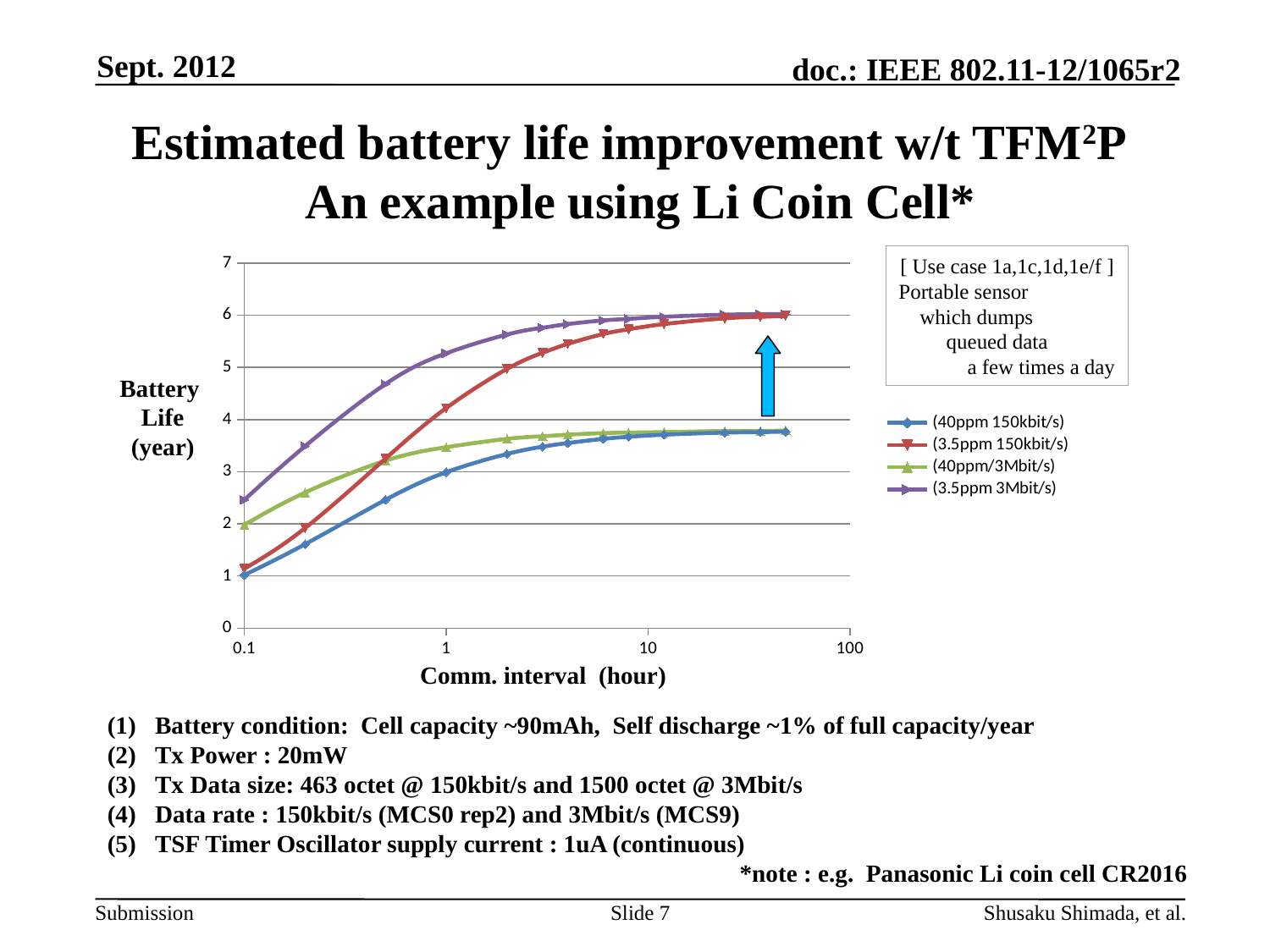
What is the title of the chart's x axis? Comm. interval (hour) Which series has the highest battery life at a communication interval of 0.1 hour? (3.5ppm 3Mbit/s) Is the battery life for (40ppm/3Mbit/s) at a 10 hour interval greater or less than 4 years? less At a 1 hour interval, which series has the larger battery life: (3.5ppm 150kbit/s) or (40ppm/3Mbit/s)? (3.5ppm 150kbit/s) Is the battery life for (3.5ppm 150kbit/s) at a 0.1 hour interval greater or less than 2 years? less What is the title of the chart's y axis? Battery Life (year) Is the battery life for (3.5ppm 3Mbit/s) at a 0.1 hour interval greater or less than 2 years? greater At a 0.1 hour interval, which series has the larger battery life: (3.5ppm 3Mbit/s) or (40ppm 150kbit/s)? (3.5ppm 3Mbit/s) Do the battery life values rise or fall as the communication interval increases along the x axis? rise What kind of chart is shown on the slide? line chart How many series does the chart's legend list? 4